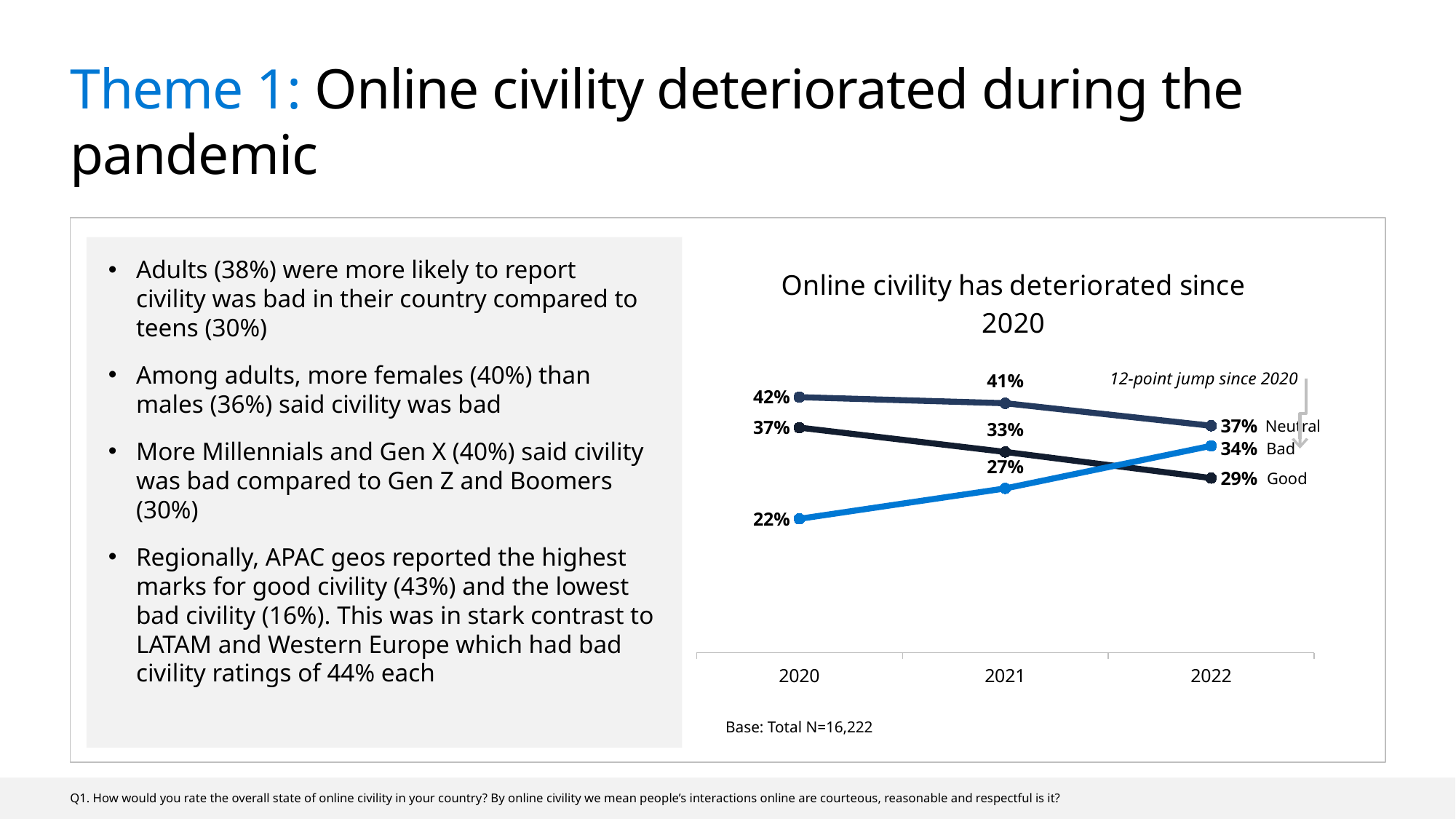
Does the Good series rise or fall from 2020 to 2022? fall Which series has the highest value in 2022? Neutral What is the value for Good in 2020? 37% What is the title of the chart? Online civility has deteriorated since 2020 How many years are shown on the x axis of the chart? 3 What is the value for Bad in 2020? 22% What type of chart is shown on the slide? line chart How many series are plotted in the chart? 3 What is the difference between the Bad value in 2022 and the Bad value in 2020? 12 percentage points What is the value for Bad in 2022? 34% What is the value for Neutral in 2021? 41% Which series has the lowest value in 2020? Bad